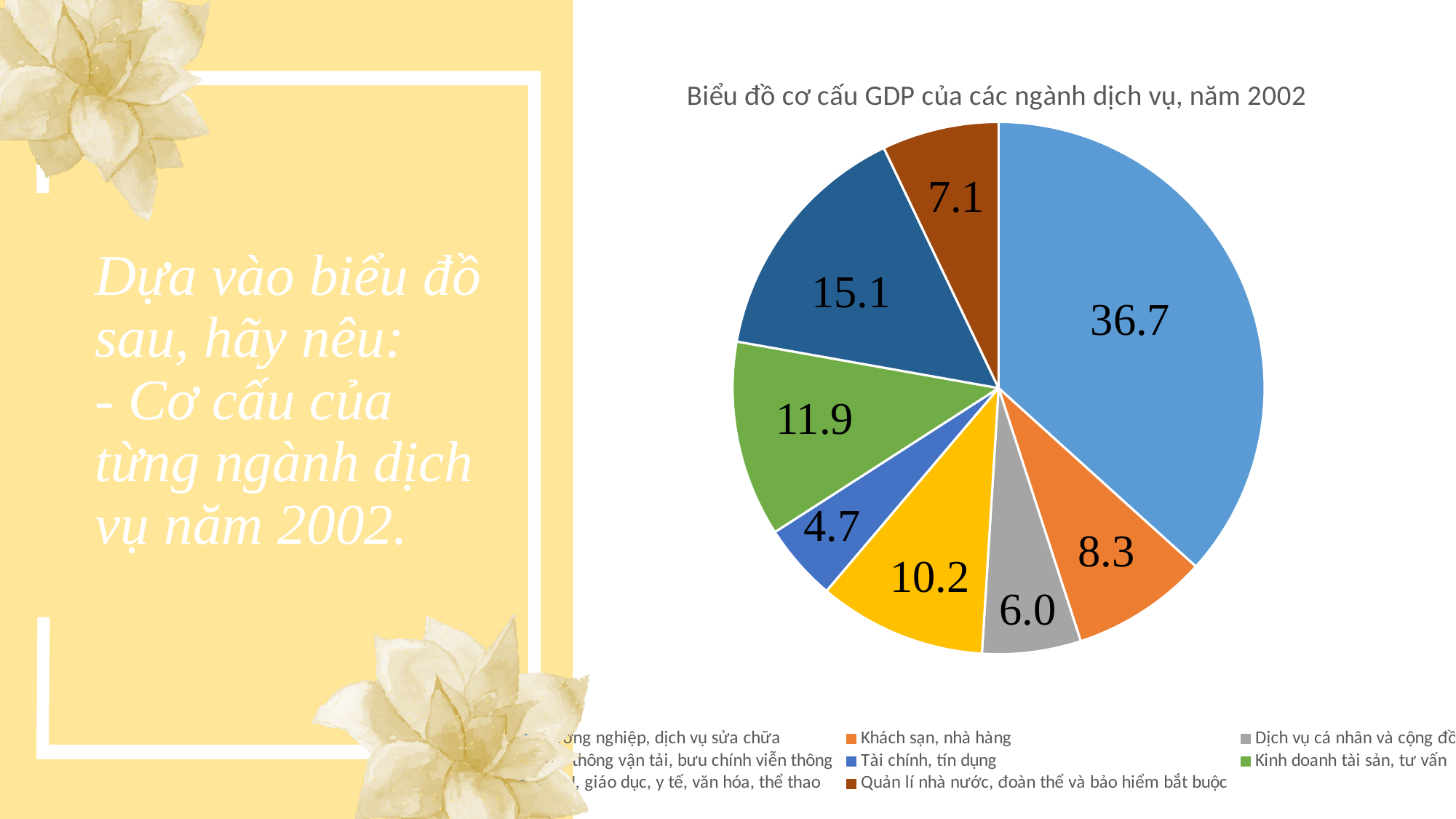
What colour is the slice for Kinh doanh tài sản, tư vấn? green What is the value shown for Quản lí nhà nước, đoàn thể và bảo hiểm bắt buộc? 7.1 What is the value shown for Tài chính, tín dụng? 4.7 What is the title of the chart? Biểu đồ cơ cấu GDP của các ngành dịch vụ, năm 2002 What kind of chart is shown on the slide? pie chart How many slices does the pie chart have? 8 What is the largest value labelled on the pie chart? 36.7 Which category has the smallest slice of the pie? Tài chính, tín dụng Which is larger: Khách sạn, nhà hàng or Quản lí nhà nước, đoàn thể và bảo hiểm bắt buộc? Khách sạn, nhà hàng What is the difference between the values for Kinh doanh tài sản, tư vấn and Khách sạn, nhà hàng? 3.6 What is the value shown for Khách sạn, nhà hàng? 8.3 What is the value shown for Kinh doanh tài sản, tư vấn? 11.9